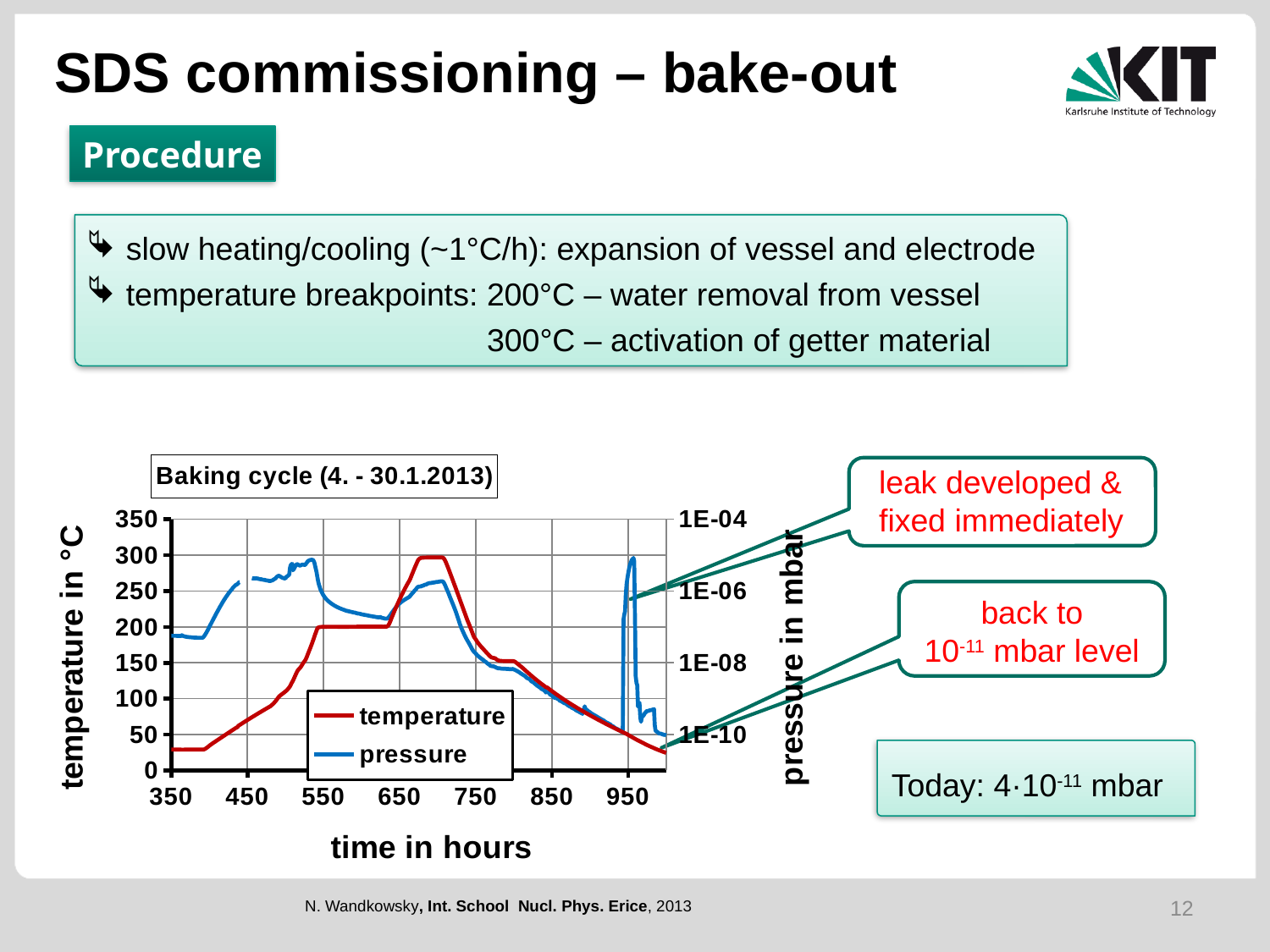
How many series does the chart legend list? 2 Is the pressure at 500 hours greater or less than 1E-06 mbar? greater What is the title of the chart? Baking cycle (4. - 30.1.2013) Which series is drawn in red in the chart? temperature Does the temperature rise or fall between 350 and 550 hours? rise Is the temperature at 700 hours greater or less than 250 °C? greater Is the pressure at 850 hours greater or less than 1E-08 mbar? less What kind of chart is shown on the slide? line chart Does the temperature rise or fall between 750 and 950 hours? fall